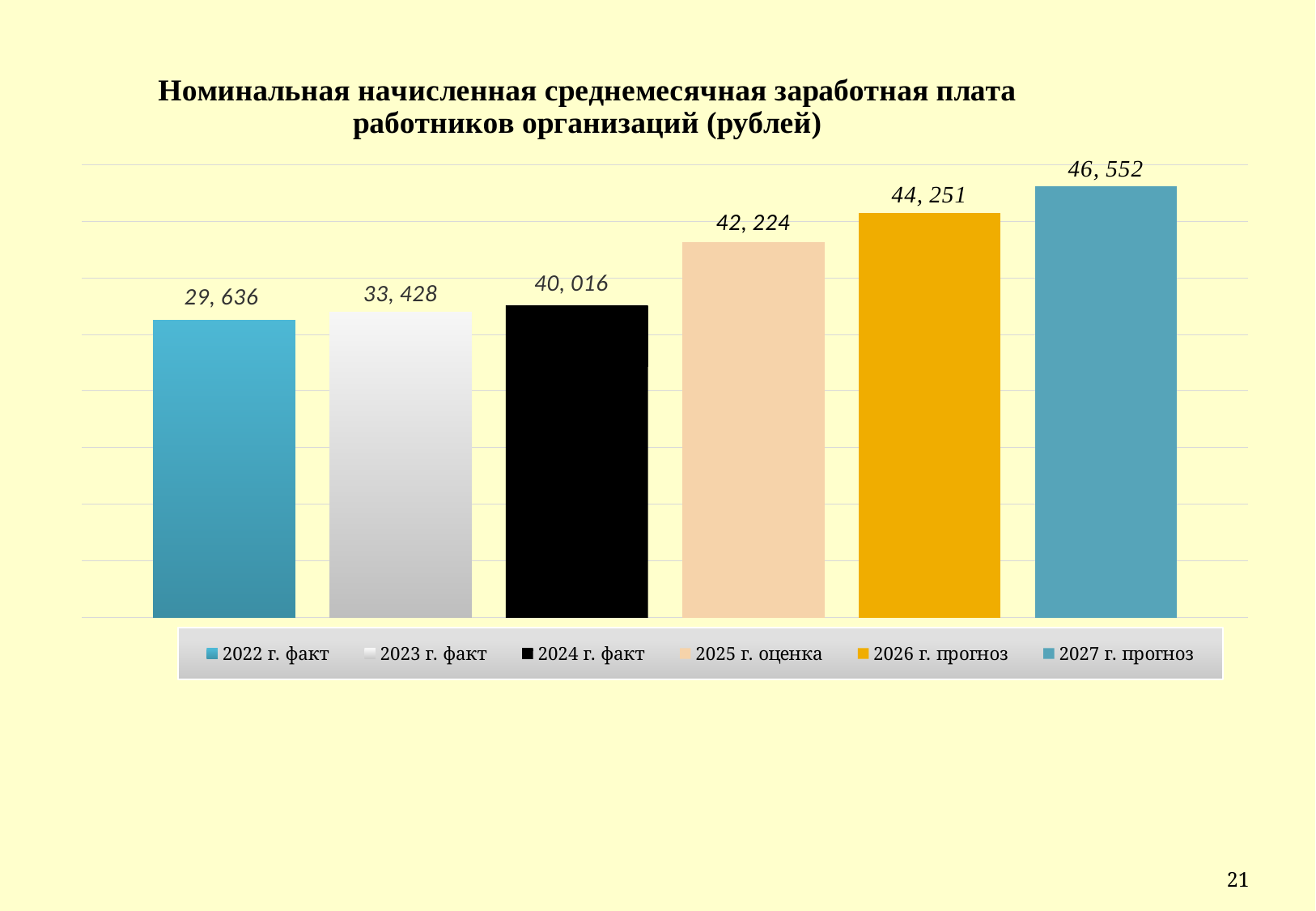
Which year has the highest value? 2027 г. прогноз How many entries does the legend list? 6 Which is larger, the value for 2024 г. факт or the value for 2023 г. факт? 2024 г. факт What is the value for 2025 г. оценка? 42, 224 What is the value for 2022 г. факт? 29, 636 What kind of chart is shown on the slide? Bar chart What is the value for 2027 г. прогноз? 46, 552 What is the difference between the values for 2026 г. прогноз and 2025 г. оценка? 2,027 What is the difference between the values for 2027 г. прогноз and 2022 г. факт? 16,916 Do the values rise or fall from 2022 to 2027? Rise Which year has the lowest value? 2022 г. факт How many bars are shown in the chart? 6